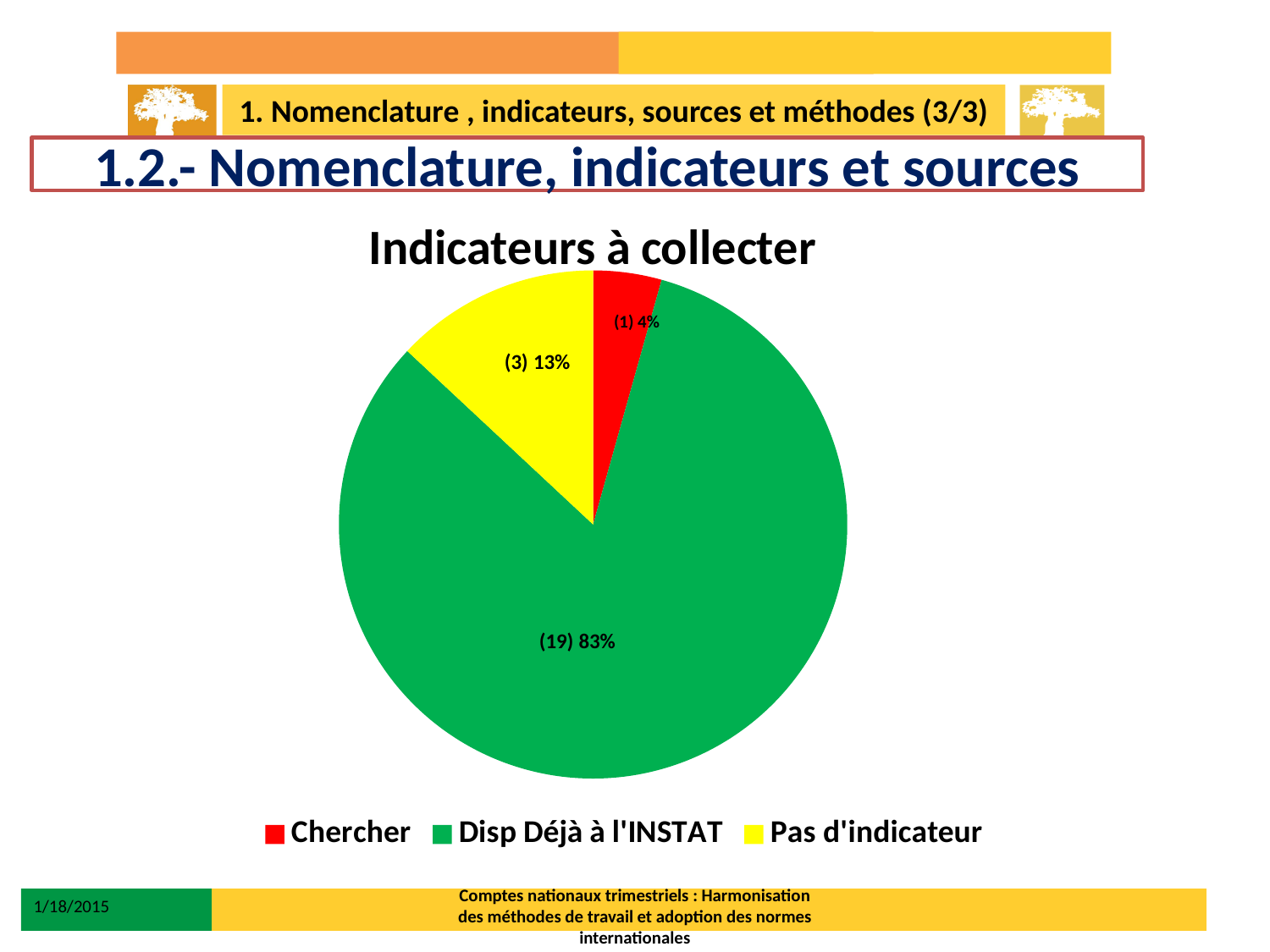
How many slices does the pie chart have? 3 Which category has the smallest slice of the pie? Chercher What percentage share does the 'Chercher' slice have? 4% How many entries does the legend list? 3 What percentage share does the 'Disp Déjà à l'INSTAT' slice have? 83% Which colour represents 'Pas d'indicateur' in the pie chart? yellow What type of chart is shown on the slide? pie chart What percentage share does the 'Pas d'indicateur' slice have? 13% How many indicators are counted in the 'Disp Déjà à l'INSTAT' slice? 19 Which category has the largest slice of the pie? Disp Déjà à l'INSTAT What is the difference in count between 'Disp Déjà à l'INSTAT' and 'Pas d'indicateur'? 16 What is the title of the chart? Indicateurs à collecter